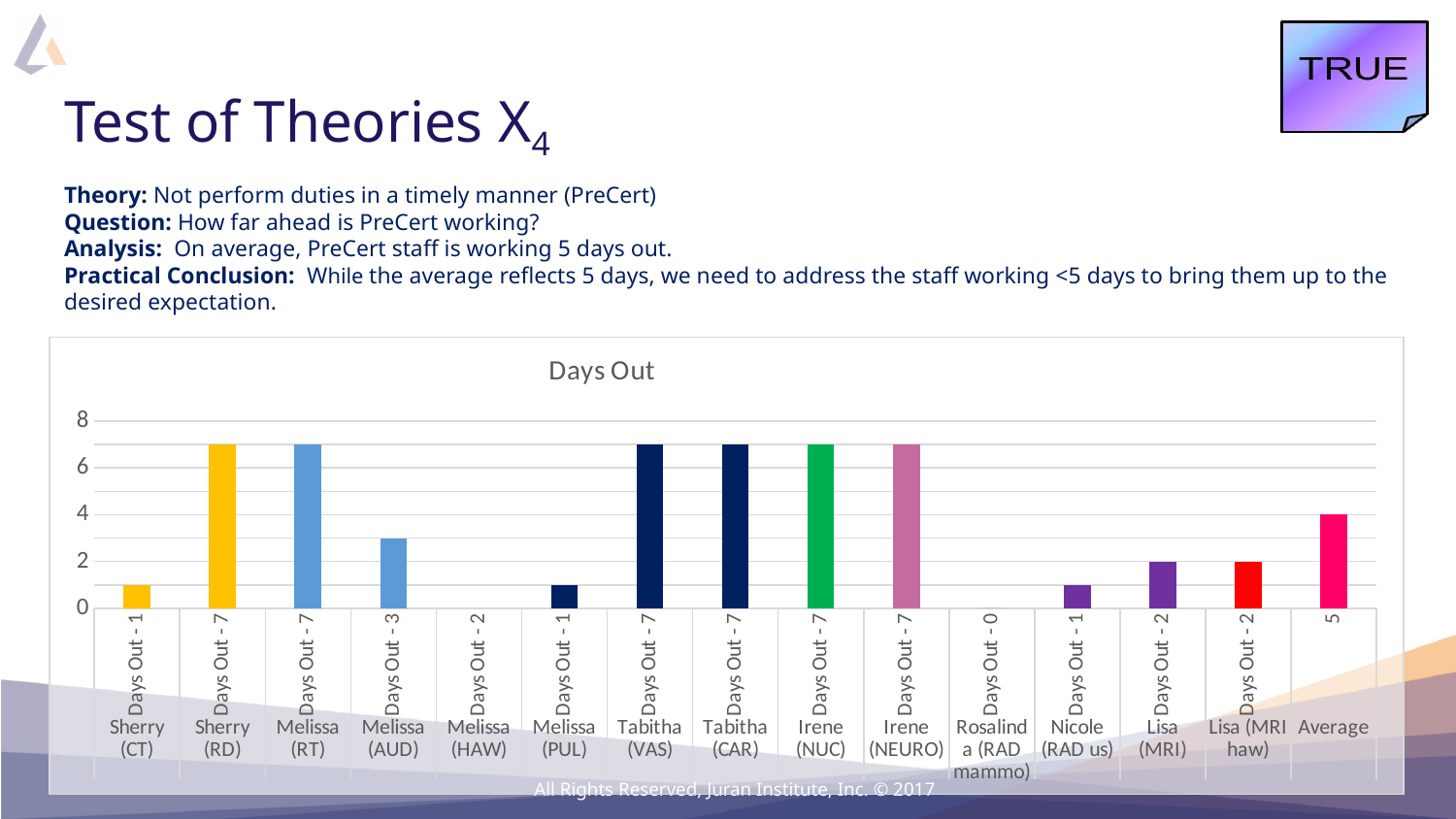
Which has a higher Days Out value, Sherry (CT) or Sherry (RD)? Sherry (RD) What is the Days Out value for Melissa (AUD)? 3 What is the title of the chart? Days Out Which has a higher Days Out value, Lisa (MRI) or Melissa (AUD)? Melissa (AUD) What is the Days Out value for Rosalinda (RAD mammo)? 0 How many categories are shown along the x axis of the chart? 15 What kind of chart is shown on the slide? Bar chart Is the Days Out value for Sherry (CT) greater or less than 4? less What is the Days Out value for Nicole (RAD us)? 1 Is the Days Out value for Irene (NUC) greater or less than 4? greater What is the difference between the Days Out values for Tabitha (VAS) and Melissa (AUD)? 4 What is the Days Out value for Sherry (RD)? 7